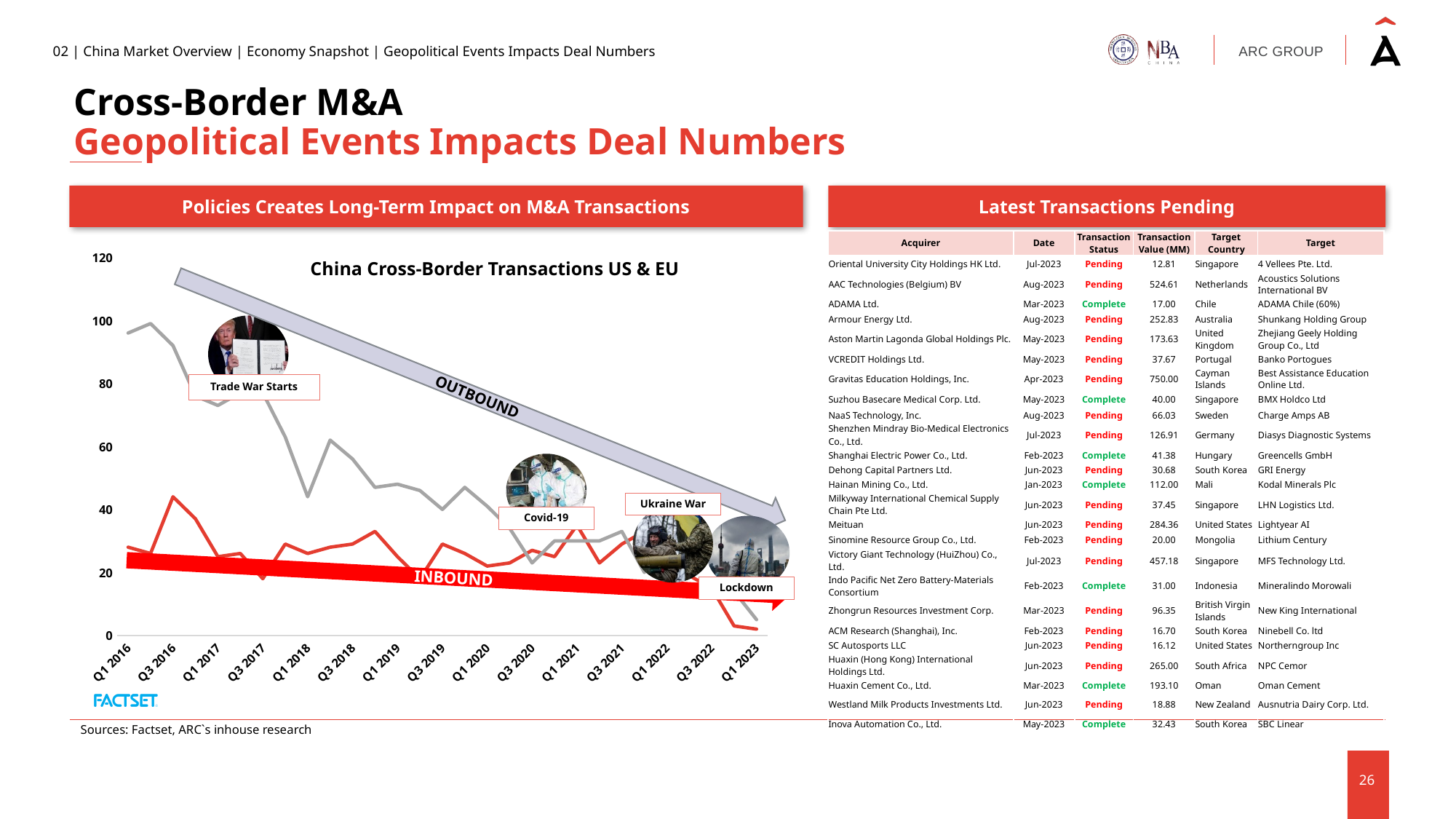
What kind of chart is "China Cross-Border Transactions US & EU"? line chart What is the highest value shown on the y axis of the China Cross-Border Transactions US & EU chart? 120 How many quarter labels are shown on the x axis of the China Cross-Border Transactions US & EU chart? 15 In the China Cross-Border Transactions US & EU chart, which line is higher at Q1 2016, OUTBOUND or INBOUND? OUTBOUND In the China Cross-Border Transactions US & EU chart, is the OUTBOUND value at Q1 2016 greater or less than 80? greater In the China Cross-Border Transactions US & EU chart, is the INBOUND value at Q1 2016 greater or less than 40? less What is the title of the chart on the left side of the slide? China Cross-Border Transactions US & EU In the China Cross-Border Transactions US & EU chart, at which quarter does the INBOUND (red) line reach its highest point? Q3 2016 In the China Cross-Border Transactions US & EU chart, at which quarter does the OUTBOUND (grey) line reach its lowest point? Q1 2023 In the China Cross-Border Transactions US & EU chart, does the OUTBOUND (grey) line generally rise or fall from Q1 2016 to Q1 2023? fall In the China Cross-Border Transactions US & EU chart, is the OUTBOUND value at Q1 2023 greater or less than 20? less